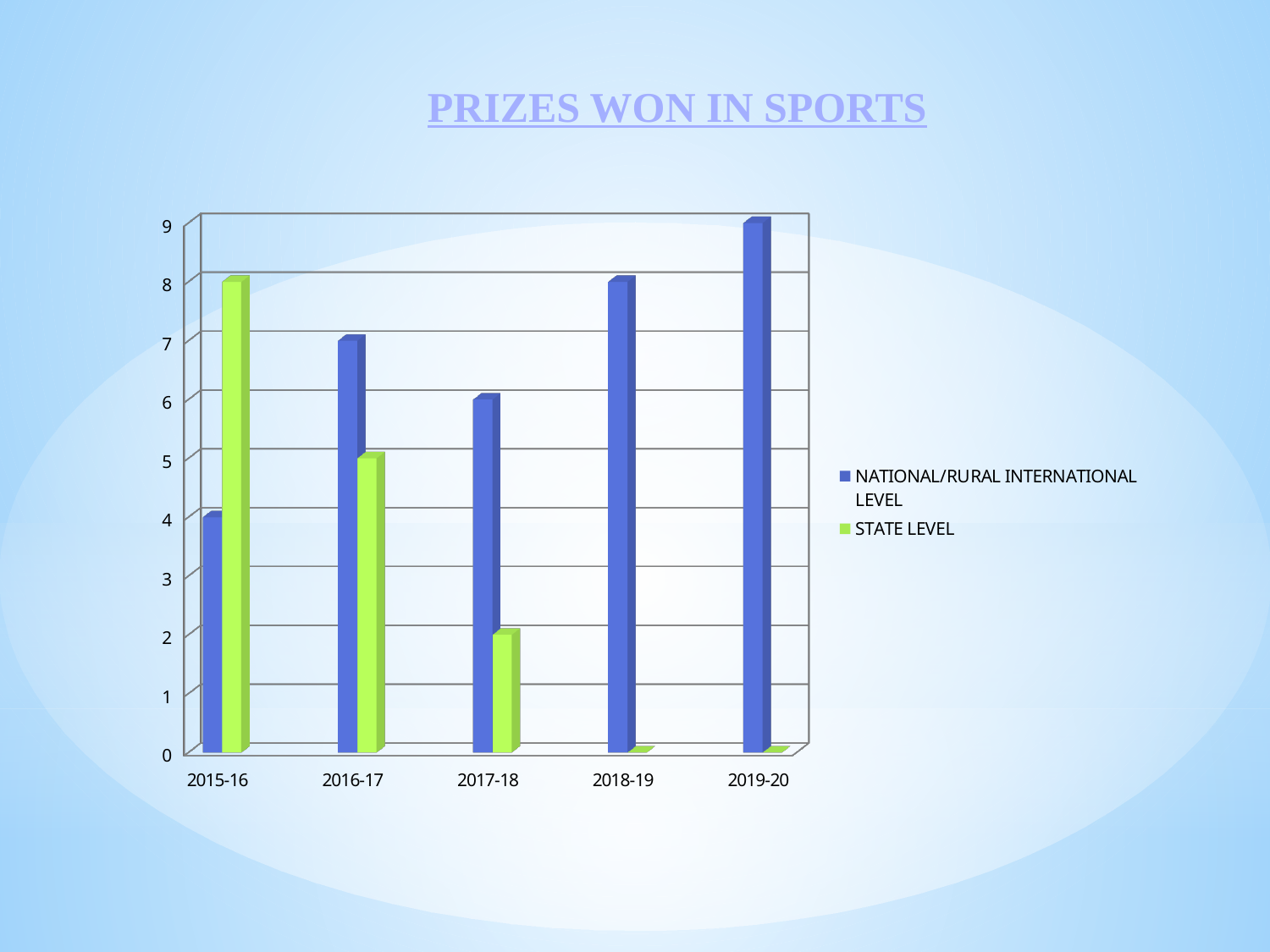
What type of chart is shown on the slide? bar chart In 2016-17, which series has the larger value, NATIONAL/RURAL INTERNATIONAL LEVEL or STATE LEVEL? NATIONAL/RURAL INTERNATIONAL LEVEL What is the value for NATIONAL/RURAL INTERNATIONAL LEVEL in 2019-20? 9 How many year categories are shown on the x axis? 5 How many series does the legend list? 2 Do the STATE LEVEL values rise or fall from 2015-16 to 2017-18? fall What is the value for NATIONAL/RURAL INTERNATIONAL LEVEL in 2016-17? 7 Which year has the highest value for NATIONAL/RURAL INTERNATIONAL LEVEL? 2019-20 Which year has the lowest value for NATIONAL/RURAL INTERNATIONAL LEVEL? 2015-16 What is the difference between the STATE LEVEL value in 2015-16 and in 2017-18? 6 What is the value for STATE LEVEL in 2015-16? 8 What is the title of the chart? PRIZES WON IN SPORTS